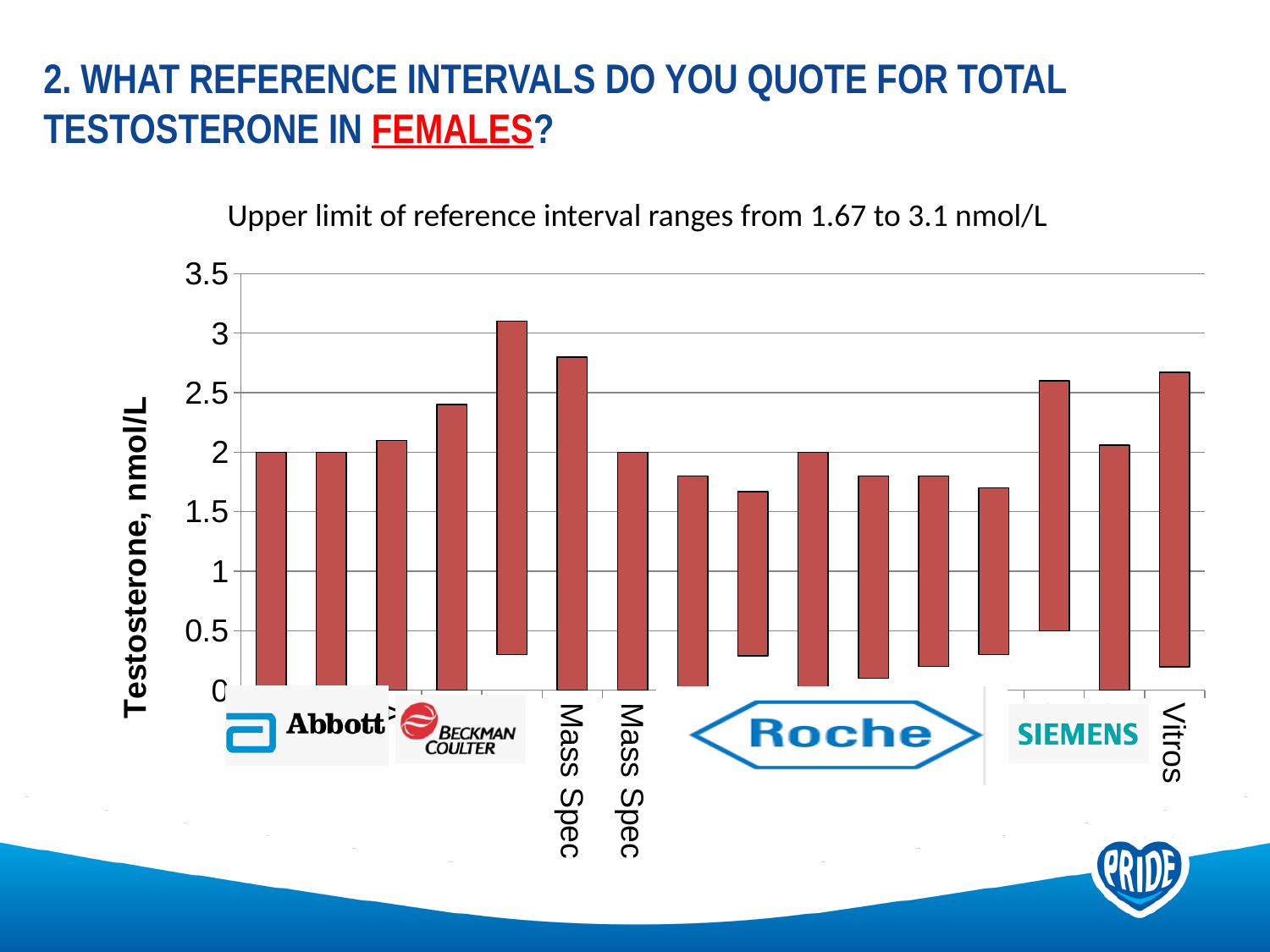
What is the label on the vertical axis of the chart? Testosterone, nmol/L Is the bottom of the Vitros bar greater or less than 0.5? less How many bars are plotted in the chart? 16 Is the top of the Vitros bar greater or less than 2.5? greater According to the chart title, what is the lowest upper limit of the reference interval quoted? 1.67 nmol/L Which reaches a higher upper value, the first Mass Spec bar or the second Mass Spec bar? the first Mass Spec bar What kind of chart is shown on the slide? bar chart Which reaches a higher upper value, the Vitros bar or the second Mass Spec bar? Vitros What is the title of the chart? Upper limit of reference interval ranges from 1.67 to 3.1 nmol/L According to the chart title, what is the highest upper limit of the reference interval quoted? 3.1 nmol/L Is the top of the second Mass Spec bar greater or less than 2.5? less